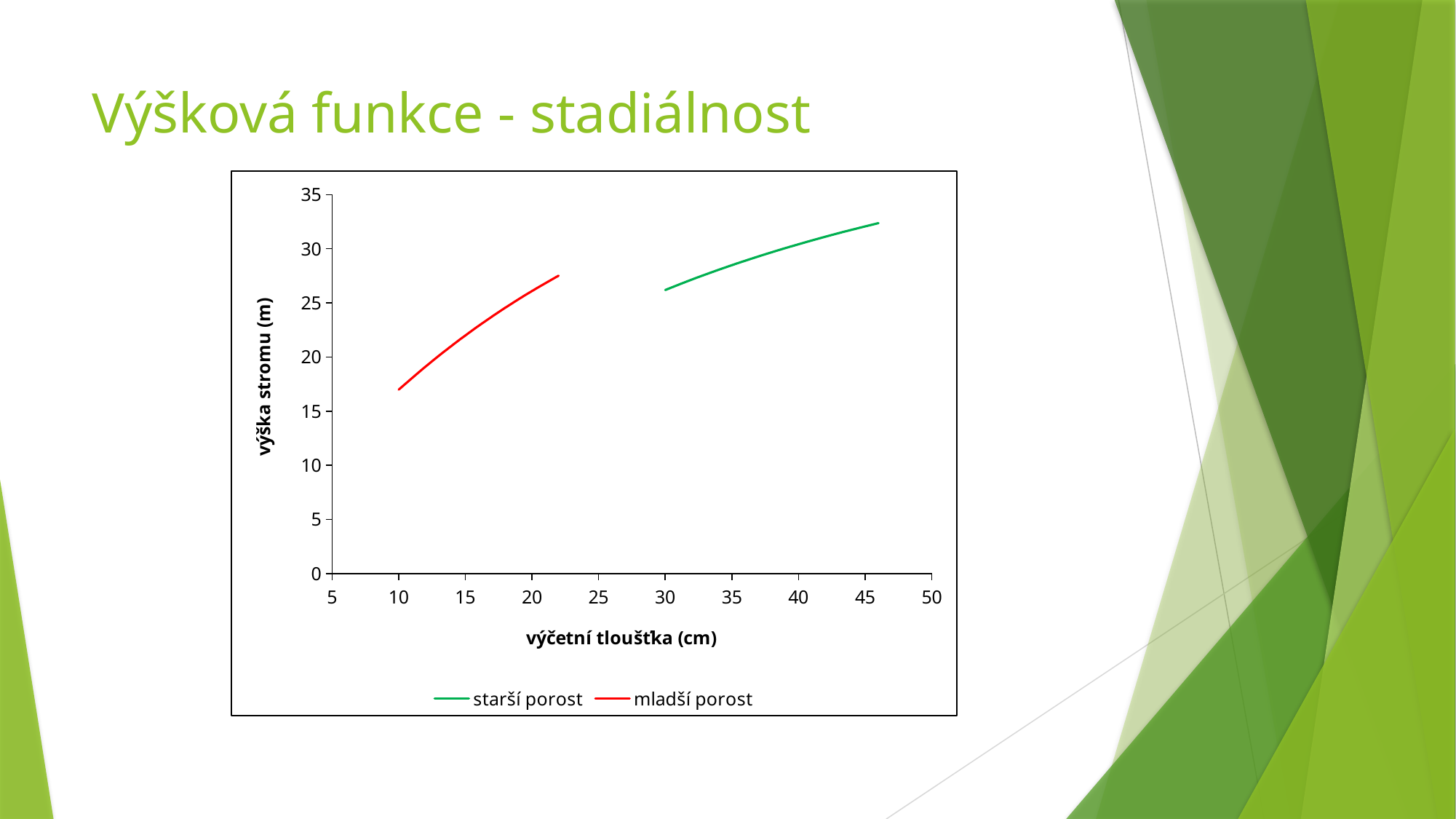
What is the title of the x axis? výčetní tloušťka (cm) Does the height of the 'mladší porost' series rise or fall as diameter increases? rise Is the value for 'starší porost' at a diameter of 45 cm greater or less than 30? greater Is the value for 'mladší porost' at a diameter of 10 cm greater or less than 20? less Which series is drawn in red? mladší porost Is the value for 'starší porost' at a diameter of 35 cm greater or less than 25? greater How many series does the legend list? 2 Which series covers the smaller diameters on the x axis, 'starší porost' or 'mladší porost'? mladší porost Which series reaches the greater maximum tree height, 'starší porost' or 'mladší porost'? starší porost Does the height of the 'starší porost' series rise or fall as diameter increases? rise What kind of chart is shown on the slide? line chart